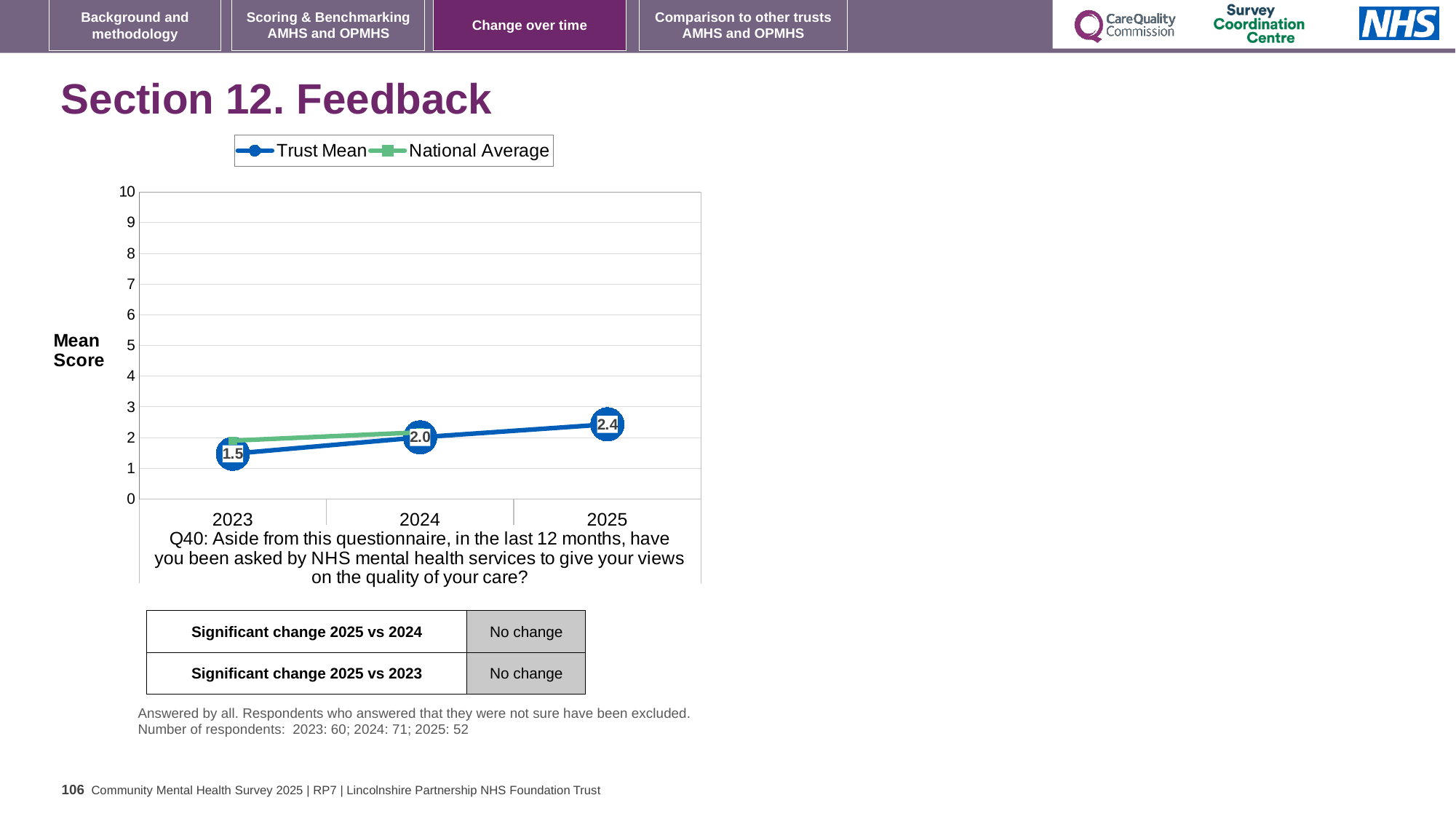
What is the difference between the Trust Mean in 2025 and in 2023? 0.9 Is the Trust Mean for 2025 greater or less than 3? less Is the National Average for 2023 greater or less than 1? greater What kind of chart is shown on the slide? Line chart How many years are shown on the x axis? 3 In which year is the Trust Mean lowest? 2023 In which year is the Trust Mean highest? 2025 Which is larger, the Trust Mean in 2024 or in 2025? 2025 What is the Trust Mean value for 2024? 2.0 What is the Trust Mean value for 2023? 1.5 How many series does the legend list? 2 What is the Trust Mean value for 2025? 2.4